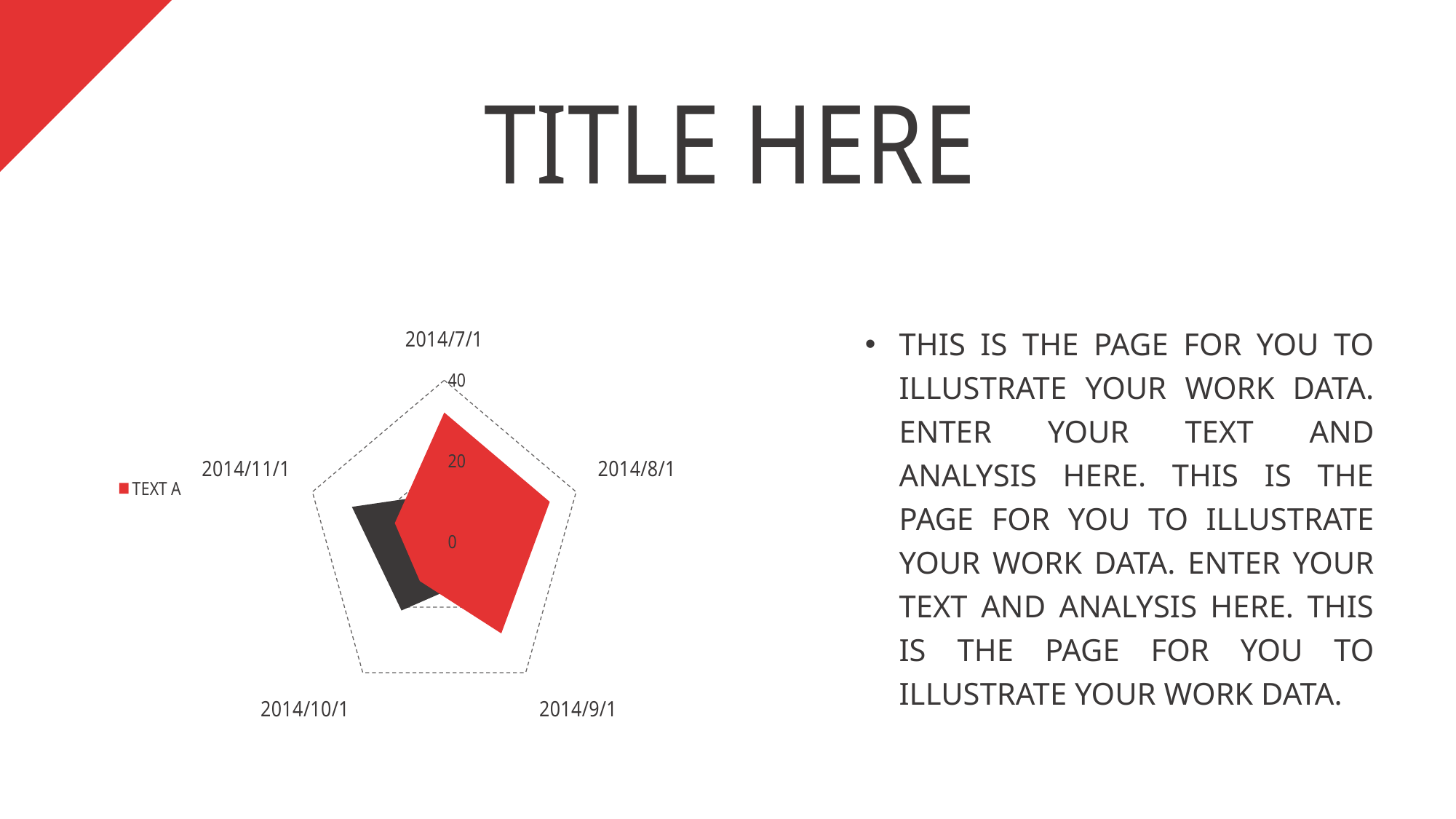
For the TEXT A series, which is larger: the value for 2014/8/1 or the value for 2014/10/1? 2014/8/1 Is the TEXT A value for 2014/11/1 greater or less than 20? less For the TEXT A series, which is larger: the value for 2014/7/1 or the value for 2014/11/1? 2014/7/1 Is the TEXT A value for 2014/10/1 greater or less than 20? less What is the name of the series shown in the chart legend? TEXT A Is the TEXT A value for 2014/8/1 greater or less than 20? greater How many series does the chart legend list? 1 What kind of chart is shown on the slide? Radar chart What colour is the TEXT A series on the radar chart? Red How many categories (dates) are plotted on the radar chart? 5